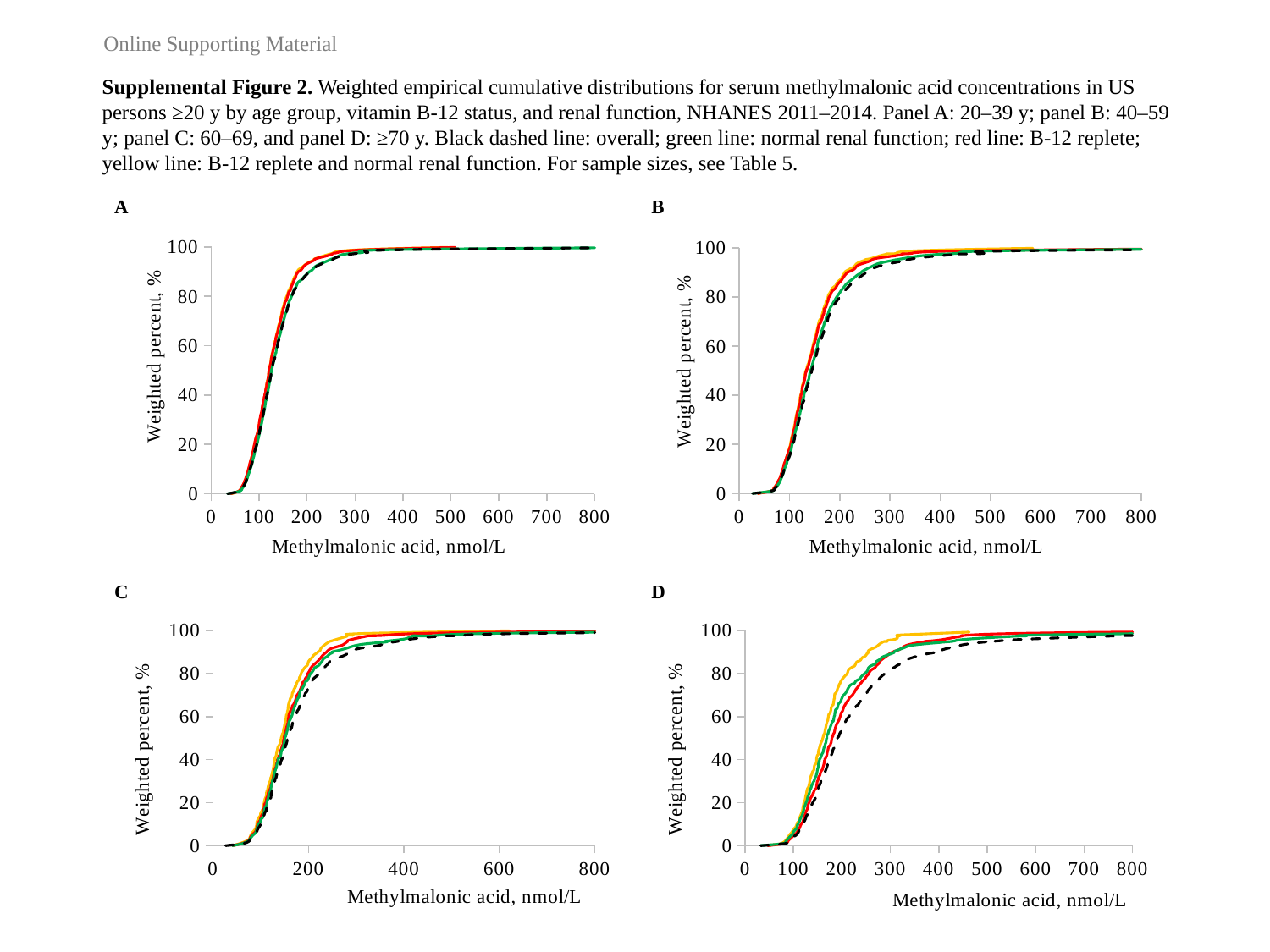
Which panel shows the widest separation between the black dashed line and the coloured lines? D What kind of chart is panel A? line chart How many chart panels are shown on the slide? 4 What is the x-axis label of panel A? Methylmalonic acid, nmol/L In panel D, at 200 nmol/L, is the value of the black dashed line greater or less than 80%? less In panel B, at 100 nmol/L, is the value of the black dashed line greater or less than 40%? less In panel C, at 100 nmol/L, is the value of the black dashed line greater or less than 40%? less What is the y-axis label of panel D? Weighted percent, % In panel D, at 200 nmol/L, which line is higher, the yellow line or the black dashed line? yellow line In panel A, do the curves rise or fall as methylmalonic acid increases along the x axis? rise